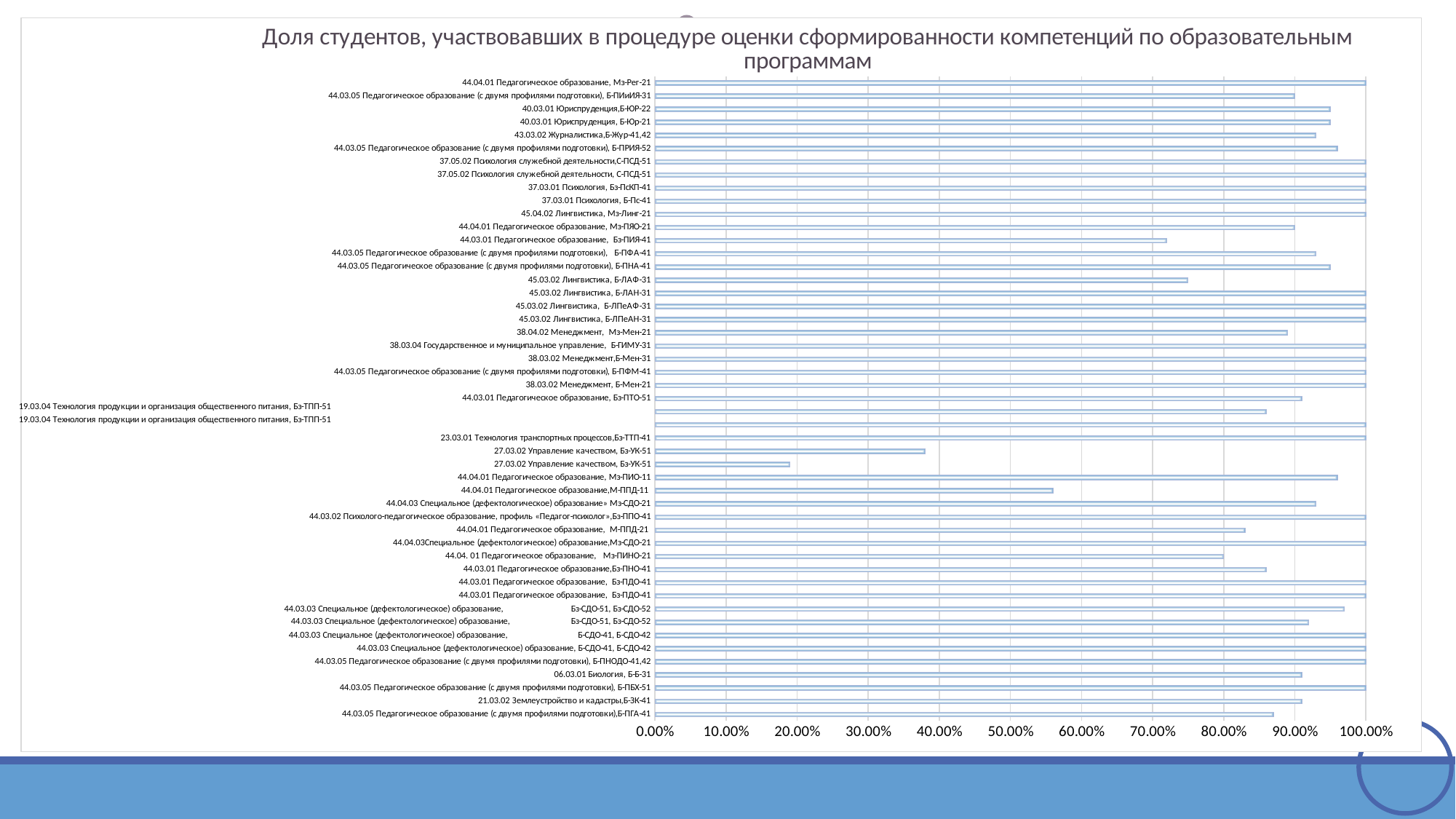
Is the value for 44.03.05 Педагогическое образование (с двумя профилями подготовки),Б-ПГА-41 greater or less than 90.00%? less Which programme has the lowest share of students in the chart? 27.03.02 Управление качеством, Бз-УК-51 Is the value for 40.03.01 Юриспруденция,Б-ЮР-22 greater or less than 90.00%? greater Is the value for 45.03.02 Лингвистика, Б-ЛАФ-31 greater or less than 70.00%? greater Which has the larger value: 45.03.02 Лингвистика, Б-ЛАФ-31 or 44.04.01 Педагогическое образование,М-ППД-11? 45.03.02 Лингвистика, Б-ЛАФ-31 What kind of chart is shown on the slide? Bar chart What is the title of the chart? Доля студентов, участвовавших в процедуре оценки сформированности компетенций по образовательным программам